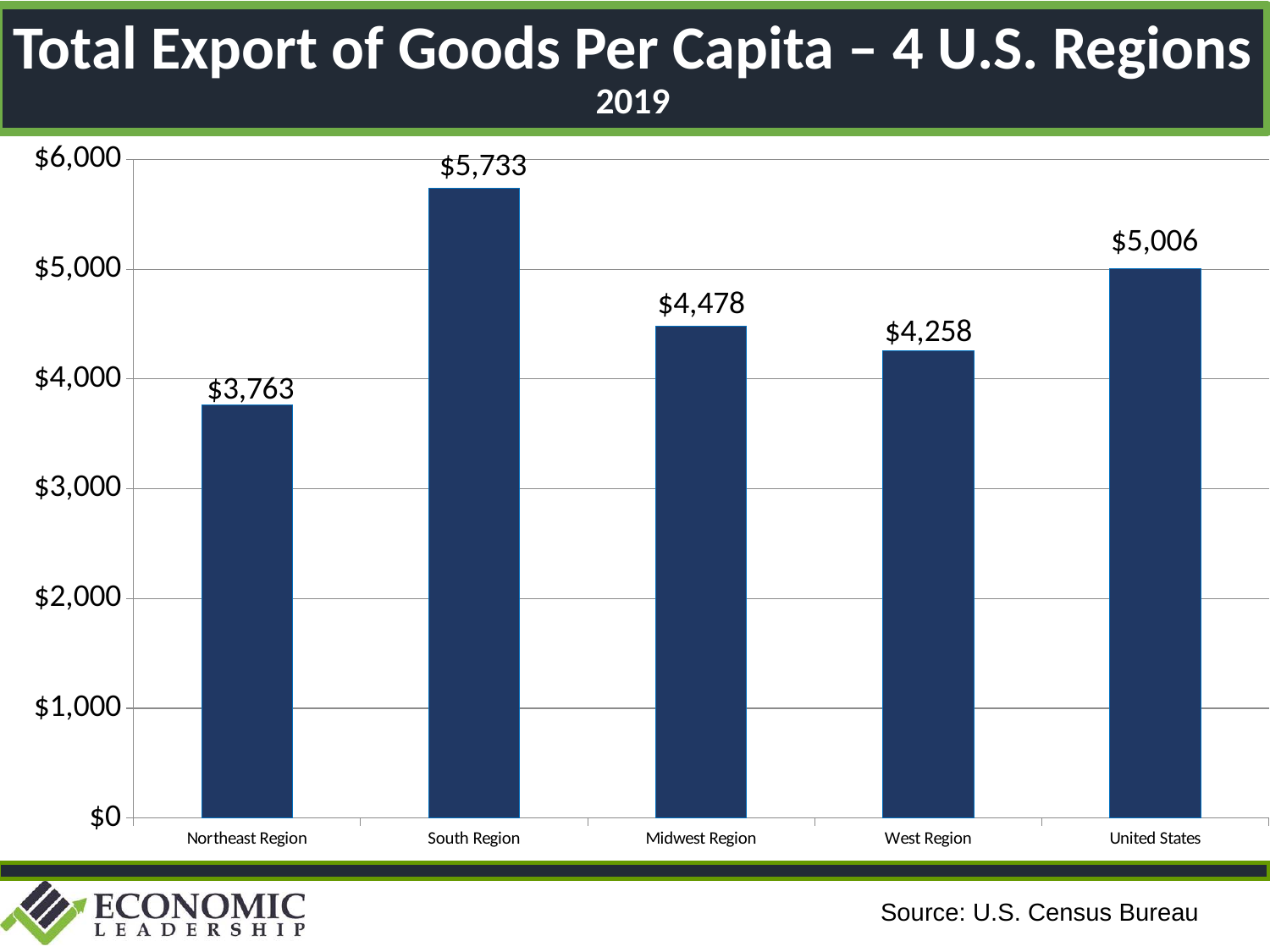
What is the total export of goods per capita for the Northeast Region? $3,763 What kind of chart is shown on the slide? Bar chart Which is larger, the value for the Midwest Region or the West Region? Midwest Region What is the total export of goods per capita for the South Region? $5,733 Which category has the highest export of goods per capita? South Region Which category has the lowest export of goods per capita? Northeast Region Is the value for the West Region greater or less than $4,000? greater What is the difference between the Midwest Region and the West Region values? $220 How many bars are shown in the chart? 5 What is the difference between the South Region and the Northeast Region values? $1,970 What is the value shown for the United States? $5,006 What year does the chart cover? 2019